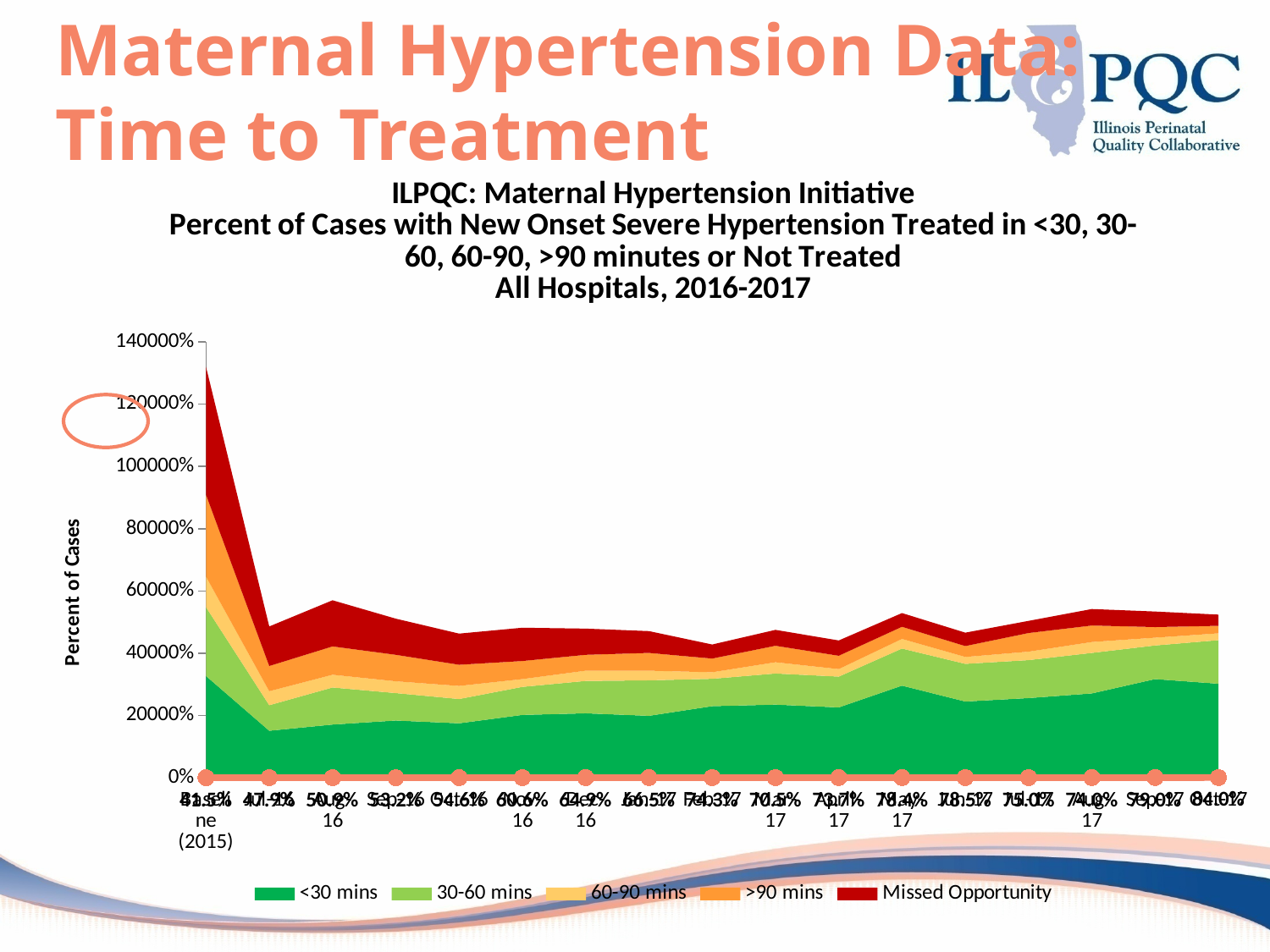
Is the total stacked value at the leftmost point greater or less than 100000%? greater Which series forms the bottom layer of the stacked area? <30 mins How many series does the chart's legend list? 5 Does the total stacked value rise or fall between the first and second points on the x axis? Fall What is the highest tick value shown on the vertical axis? 140000% What is the label on the chart's vertical axis? Percent of Cases Which legend entry is shown in red? Missed Opportunity What kind of chart is shown on the slide? Stacked area chart